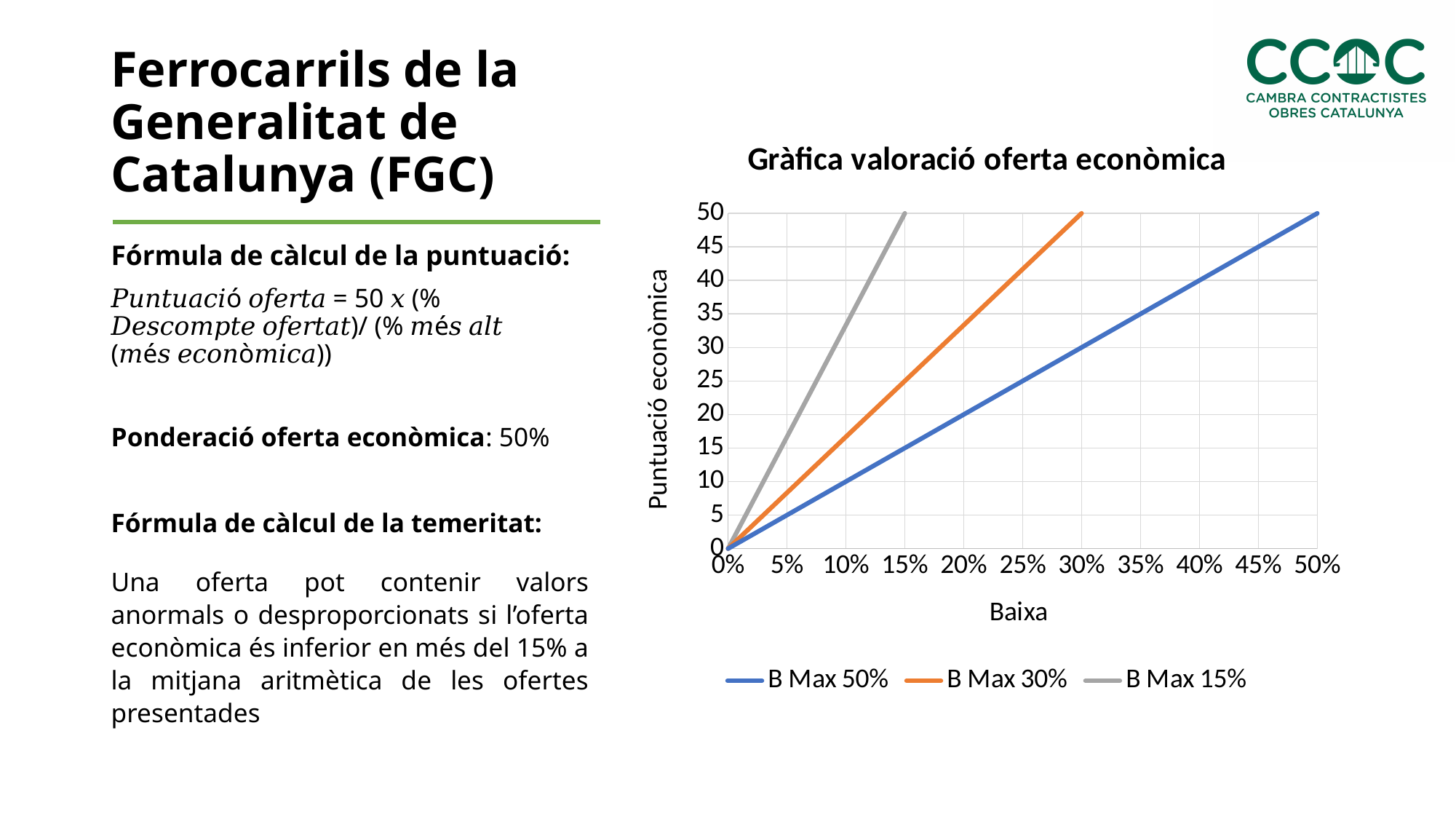
What is the title of the chart? Gràfica valoració oferta econòmica Is the value of the B Max 50% line at a Baixa of 10% greater or less than 20? less What is the Puntuació econòmica of all three lines at a Baixa of 0%? 0 At which value of Baixa does the B Max 15% line reach 50 points? 15% What is the Puntuació econòmica of the B Max 50% line at a Baixa of 50%? 50 Is the value of the B Max 15% line at a Baixa of 10% greater or less than 30? greater What kind of chart is shown on the slide? line chart At a Baixa of 10%, which line is higher, B Max 15% or B Max 50%? B Max 15% At which value of Baixa does the B Max 30% line reach 50 points? 30% Do the values of the B Max 50% line rise or fall as Baixa increases? rise How many series does the legend of the chart list? 3 What is the label of the vertical axis of the chart? Puntuació econòmica